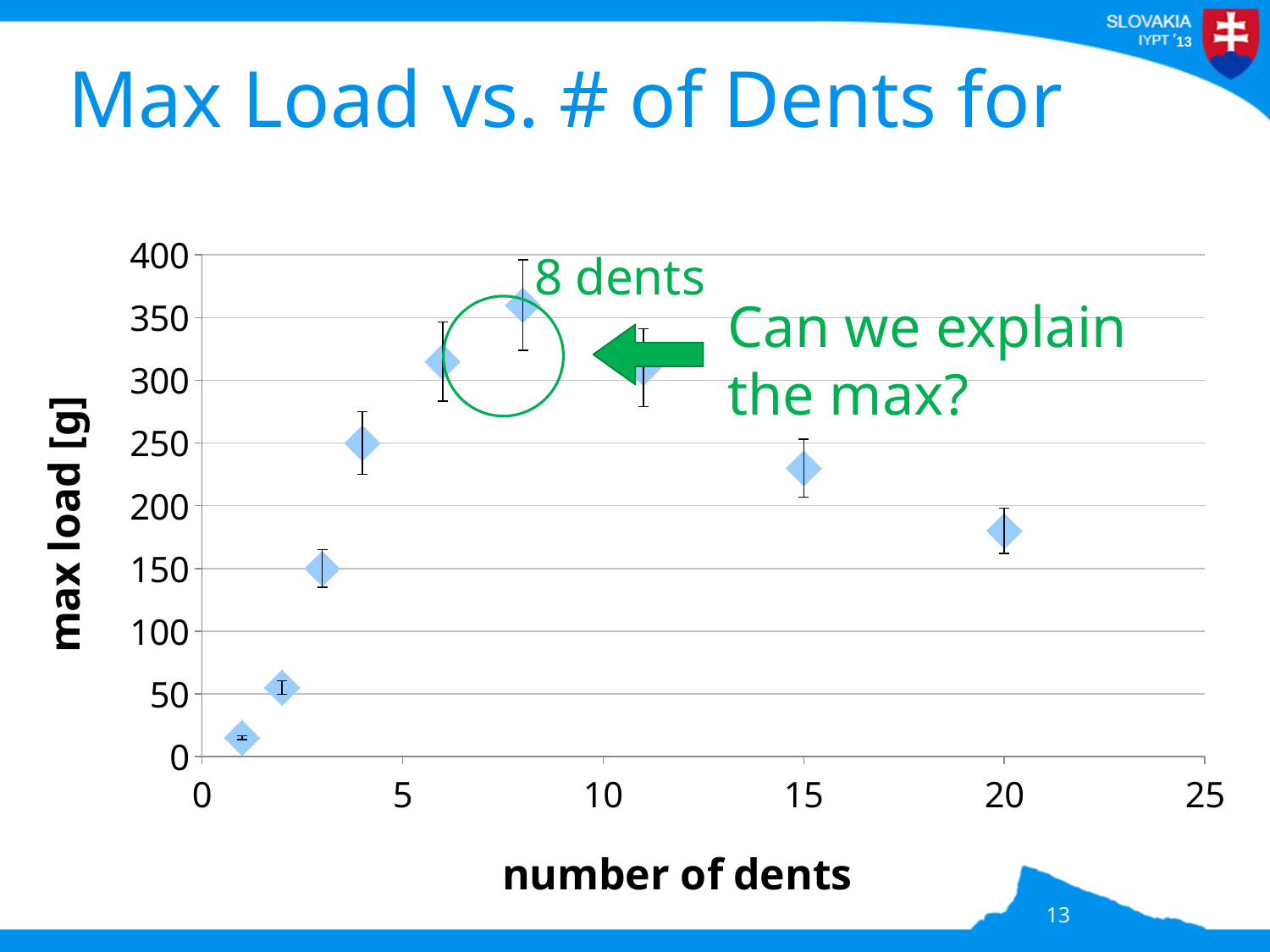
Is the max load for 8 dents greater or less than 350 g? greater Which has a higher max load: 2 dents or 15 dents? 15 dents Is the max load for 2 dents greater or less than 100 g? less At which number of dents is the max load highest? 8 Which has a higher max load: 6 dents or 20 dents? 6 dents How does the max load change as the number of dents increases from 8 to 20? it falls Is the max load for 15 dents greater or less than 200 g? greater How many data points are plotted in the chart? 9 At which number of dents is the max load lowest? 1 What kind of chart is shown on the slide? scatter chart What is the label of the y axis? max load [g]